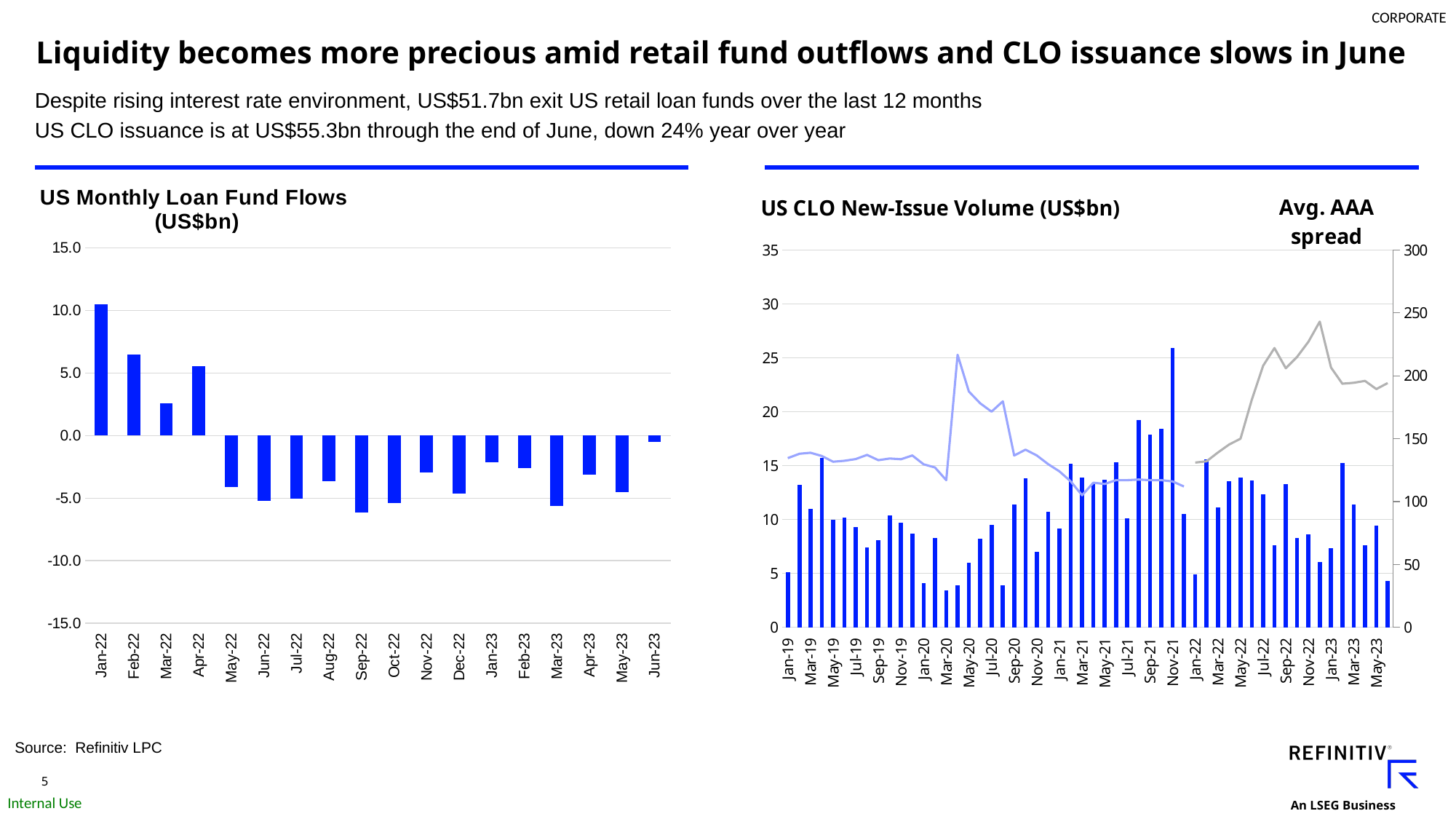
In the 'US Monthly Loan Fund Flows (US$bn)' chart, which is larger, the value for Jan-22 or Feb-22? Jan-22 In the 'US Monthly Loan Fund Flows (US$bn)' chart, how many months are plotted? 18 In the 'US CLO New-Issue Volume (US$bn)' chart, what does the line plotted on the right-hand axis represent? Avg. AAA spread In the 'US Monthly Loan Fund Flows (US$bn)' chart, is the value for Feb-22 greater or less than 5.0? greater What kind of chart is the 'US Monthly Loan Fund Flows (US$bn)' chart? bar chart In the 'US Monthly Loan Fund Flows (US$bn)' chart, is the value for Sep-22 greater or less than -5.0? less In the 'US Monthly Loan Fund Flows (US$bn)' chart, which month has the lowest value? Sep-22 In the 'US CLO New-Issue Volume (US$bn)' chart, is the bar for Nov-21 greater or less than 20? greater In the 'US Monthly Loan Fund Flows (US$bn)' chart, which month has the highest value? Jan-22 In the 'US CLO New-Issue Volume (US$bn)' chart, which month has the tallest bar? Nov-21 In the 'US Monthly Loan Fund Flows (US$bn)' chart, do the values rise or fall from Jan-22 to Jun-22? fall